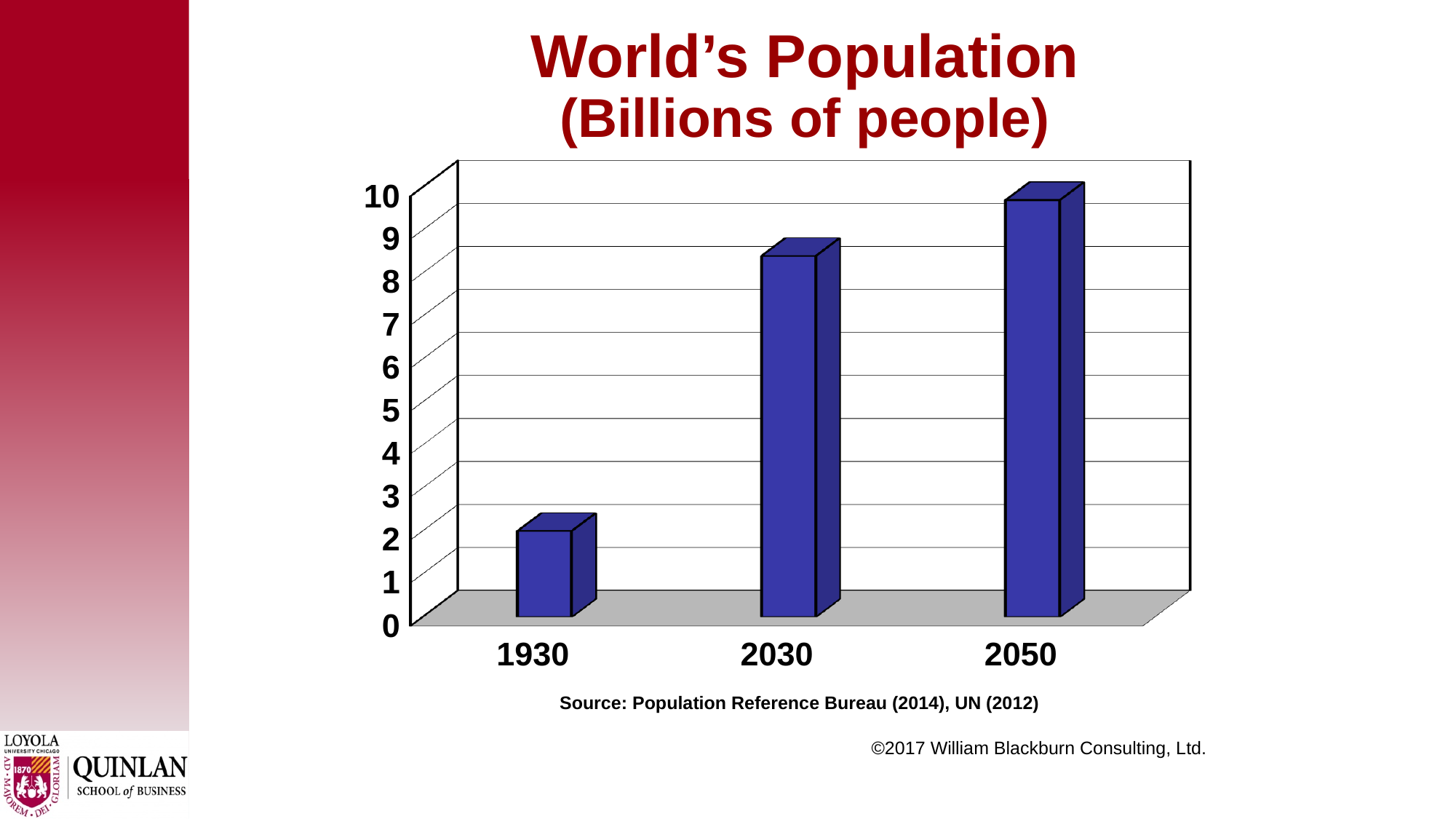
Which year has the lowest world population in the chart? 1930 Which is larger, the value for 2030 or the value for 2050? 2050 Do the values rise or fall from 1930 to 2050 along the x axis? rise Is the value for 2050 greater or less than 9? greater What kind of chart is shown on the slide? bar chart Which year has the highest world population in the chart? 2050 Is the value for 2030 greater or less than 9? less Is the value for 2030 greater or less than 8? greater How many years are shown on the x axis of the chart? 3 What unit does the chart title say the population is measured in? Billions of people